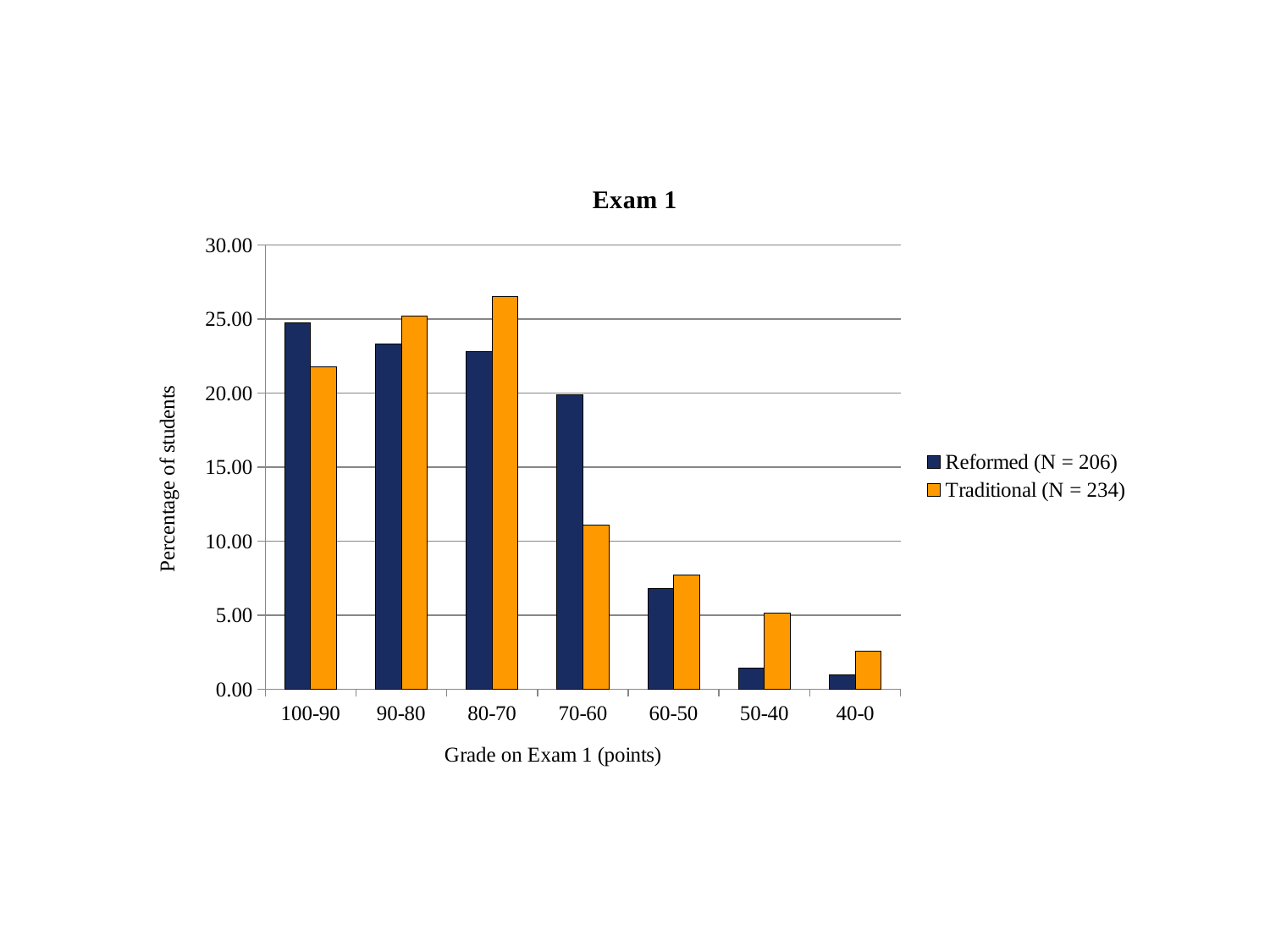
How many grade categories are shown on the x axis? 7 Which grade category has the highest value for the Reformed series? 100-90 Is the value for Traditional in the 70-60 category greater or less than 15.00? less For the 50-40 category, which series has the larger value, Reformed or Traditional? Traditional Which grade category has the lowest value for the Traditional series? 40-0 Do the Reformed values rise or fall as you move from 100-90 to 40-0 along the x axis? fall How many series does the legend list? 2 Is the value for Reformed in the 70-60 category greater or less than 15.00? greater What is the title of the chart? Exam 1 For the 70-60 category, which series has the larger value, Reformed or Traditional? Reformed What kind of chart is shown on the slide? bar chart Which grade category has the highest value for the Traditional series? 80-70